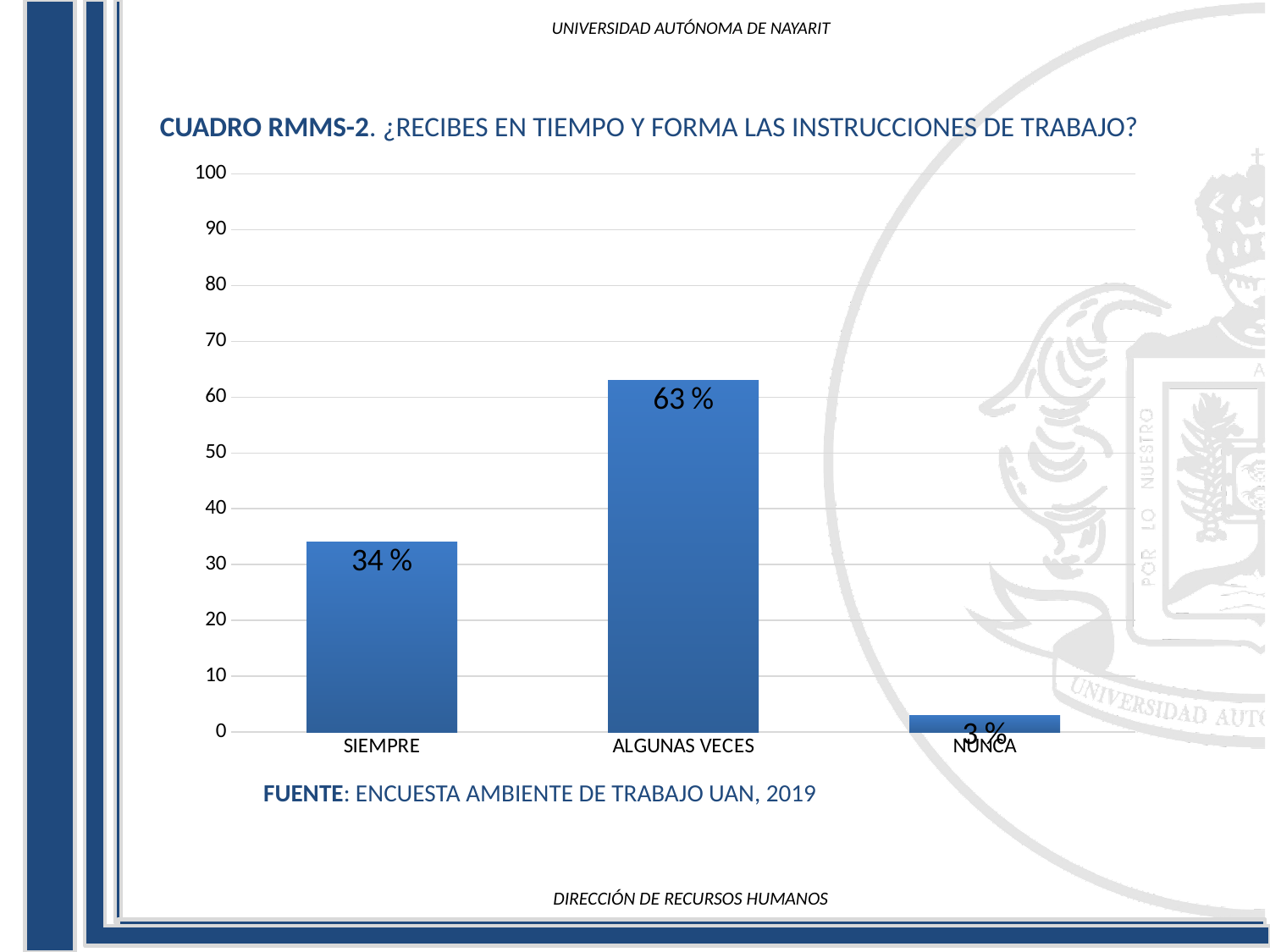
Is the value for ALGUNAS VECES greater or less than 50? greater Which category has the highest value? ALGUNAS VECES What is the value for ALGUNAS VECES? 63 % What is the value for SIEMPRE? 34 % Which is larger, the value for SIEMPRE or the value for NUNCA? SIEMPRE What is the value for NUNCA? 3 % How many categories are shown on the x axis? 3 Which category has the lowest value? NUNCA What is the maximum value shown on the y axis? 100 What is the difference between the values for ALGUNAS VECES and SIEMPRE? 29 % What is the source cited below the chart? ENCUESTA AMBIENTE DE TRABAJO UAN, 2019 What kind of chart is shown on the slide? bar chart